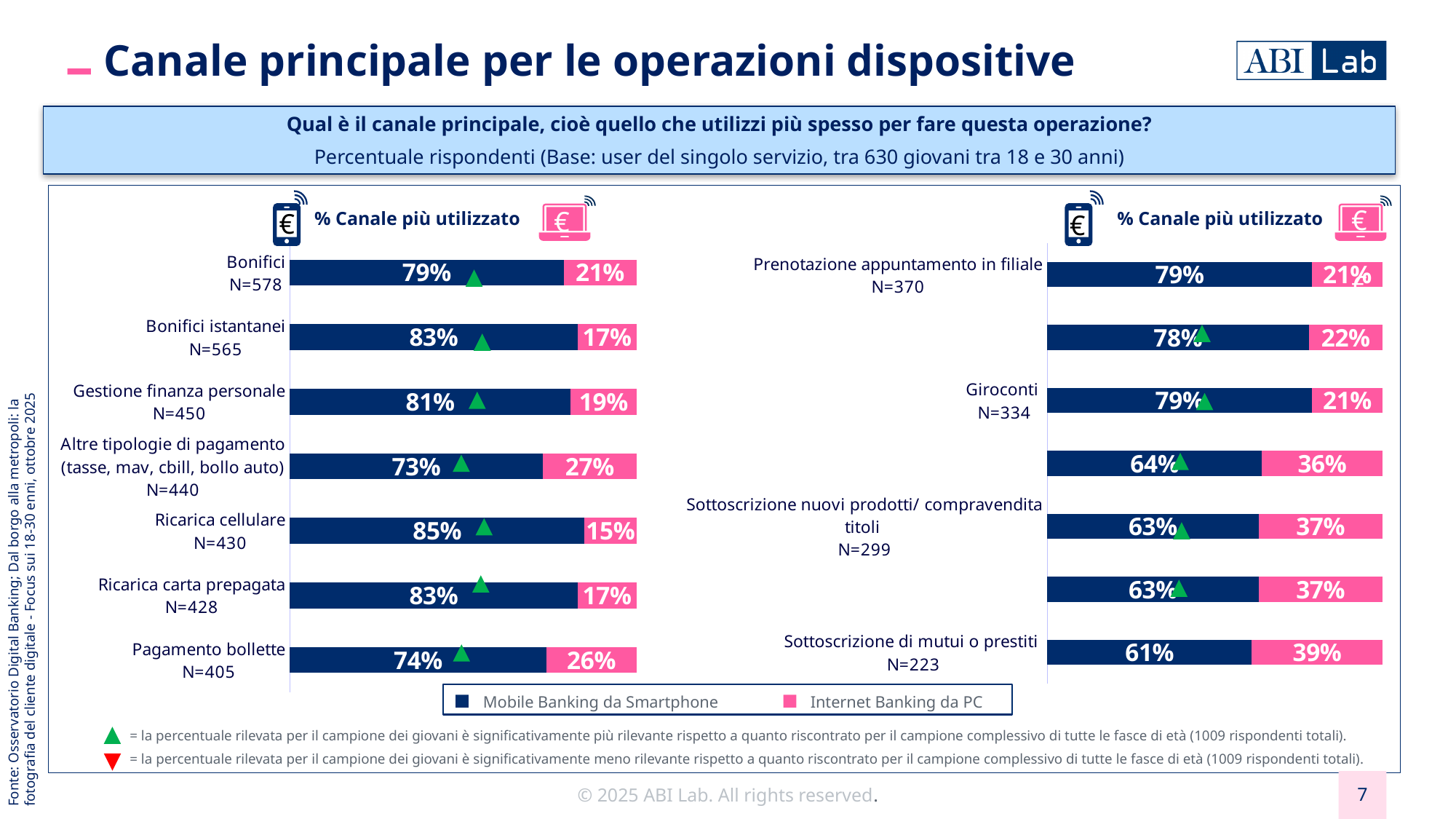
On the right chart, what is the Mobile Banking da Smartphone percentage for Giroconti? 79% How many series does the legend list? 2 On the left chart, which category has the highest Mobile Banking da Smartphone percentage? Ricarica cellulare On the left chart, which category has the lowest Mobile Banking da Smartphone percentage? Altre tipologie di pagamento (tasse, mav, cbill, bollo auto) What type of chart is used on the slide? Bar chart On the right chart, what is the Internet Banking da PC percentage for Sottoscrizione di mutui o prestiti? 39% On the left chart, what is the difference between the Mobile Banking da Smartphone percentages for Ricarica cellulare and Pagamento bollette? 11% On the right chart, what is the difference between the Internet Banking da PC percentages for Sottoscrizione di mutui o prestiti and Giroconti? 18% On the right chart, which has a higher Mobile Banking da Smartphone percentage: Prenotazione appuntamento in filiale or Sottoscrizione di mutui o prestiti? Prenotazione appuntamento in filiale On the left chart, what percentage of Bonifici users use Mobile Banking da Smartphone as their main channel? 79% How many categories are shown on the left chart? 7 On the left chart, what is the Internet Banking da PC percentage for Pagamento bollette? 26%